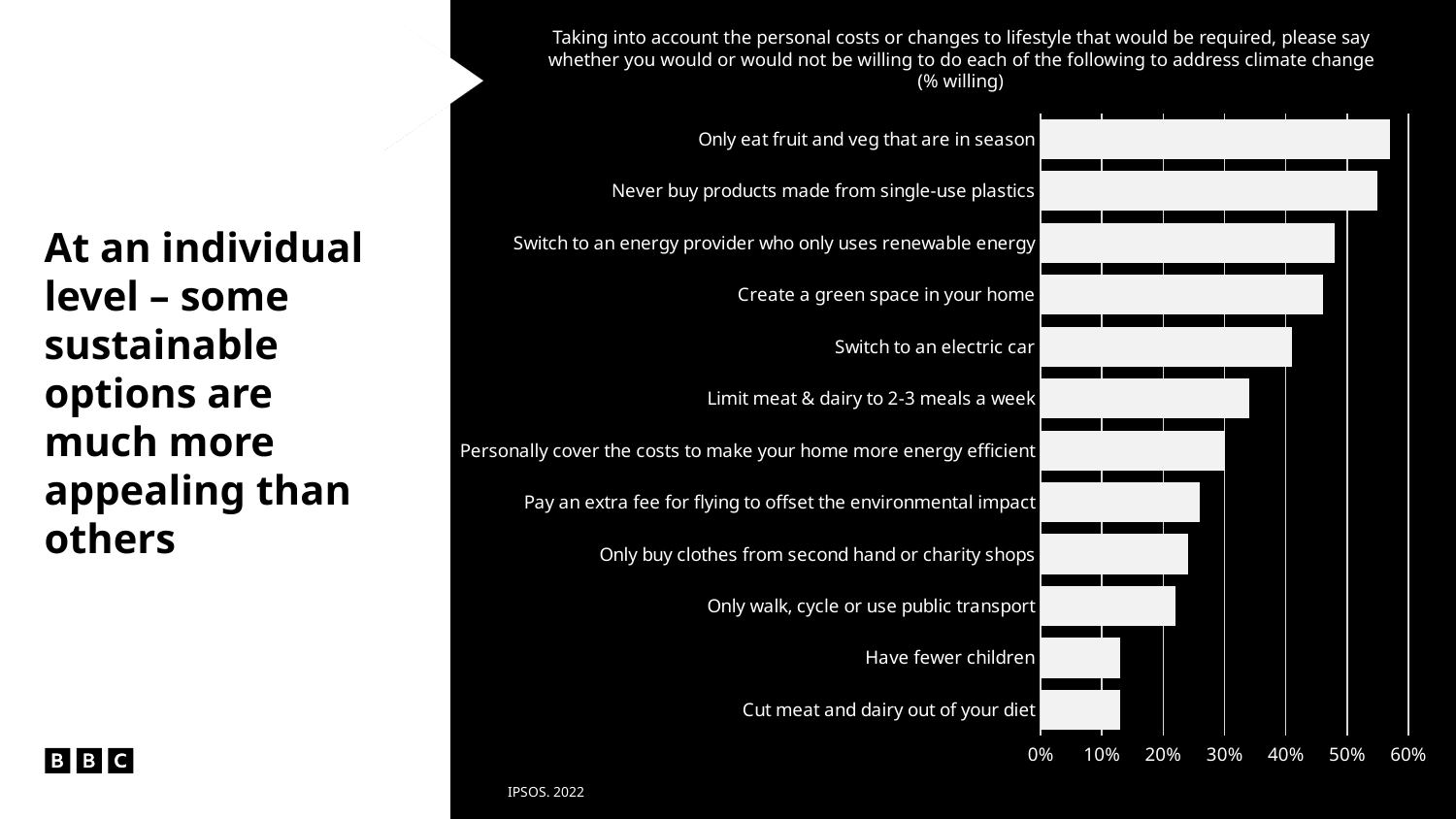
Is the value for 'Only walk, cycle or use public transport' greater or less than 30%? less Which has a higher value: 'Personally cover the costs to make your home more energy efficient' or 'Only buy clothes from second hand or charity shops'? Personally cover the costs to make your home more energy efficient What kind of chart is shown on the slide? bar chart Is the value for 'Only eat fruit and veg that are in season' greater or less than 50%? greater Is the value for 'Create a green space in your home' greater or less than 50%? less Which has a higher value: 'Switch to an electric car' or 'Limit meat & dairy to 2-3 meals a week'? Switch to an electric car What source is cited below the chart? IPSOS. 2022 What is the highest tick value shown on the x axis of the chart? 60% How many categories (actions) are plotted in the chart? 12